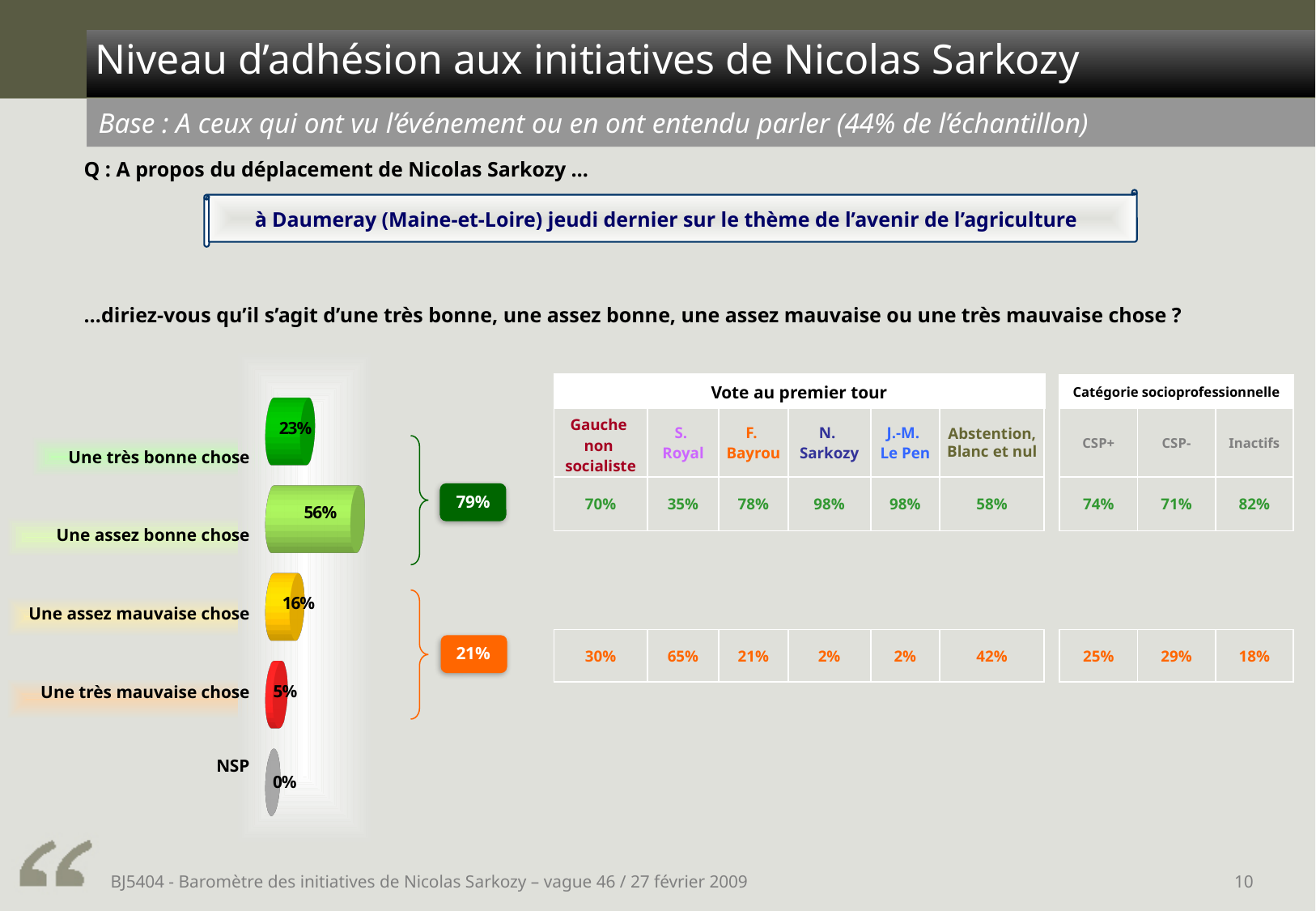
What is the difference between "Une assez bonne chose" and "Une très bonne chose" in the bar chart? 33 percentage points Which is larger in the bar chart: "Une assez mauvaise chose" or "Une très mauvaise chose"? Une assez mauvaise chose What kind of chart is shown on the slide? Bar chart What is the value for "Une très mauvaise chose" in the bar chart? 5% What is the combined total of "Une très bonne chose" and "Une assez bonne chose" shown next to the bar chart? 79% Which category has the lowest value in the bar chart? NSP What is the value for "NSP" in the bar chart? 0% What is the value for "Une assez bonne chose" in the bar chart? 56% Which category has the highest value in the bar chart? Une assez bonne chose What is the value for "Une très bonne chose" in the bar chart? 23% What is the value for "Une assez mauvaise chose" in the bar chart? 16% How many categories are shown in the bar chart? 5